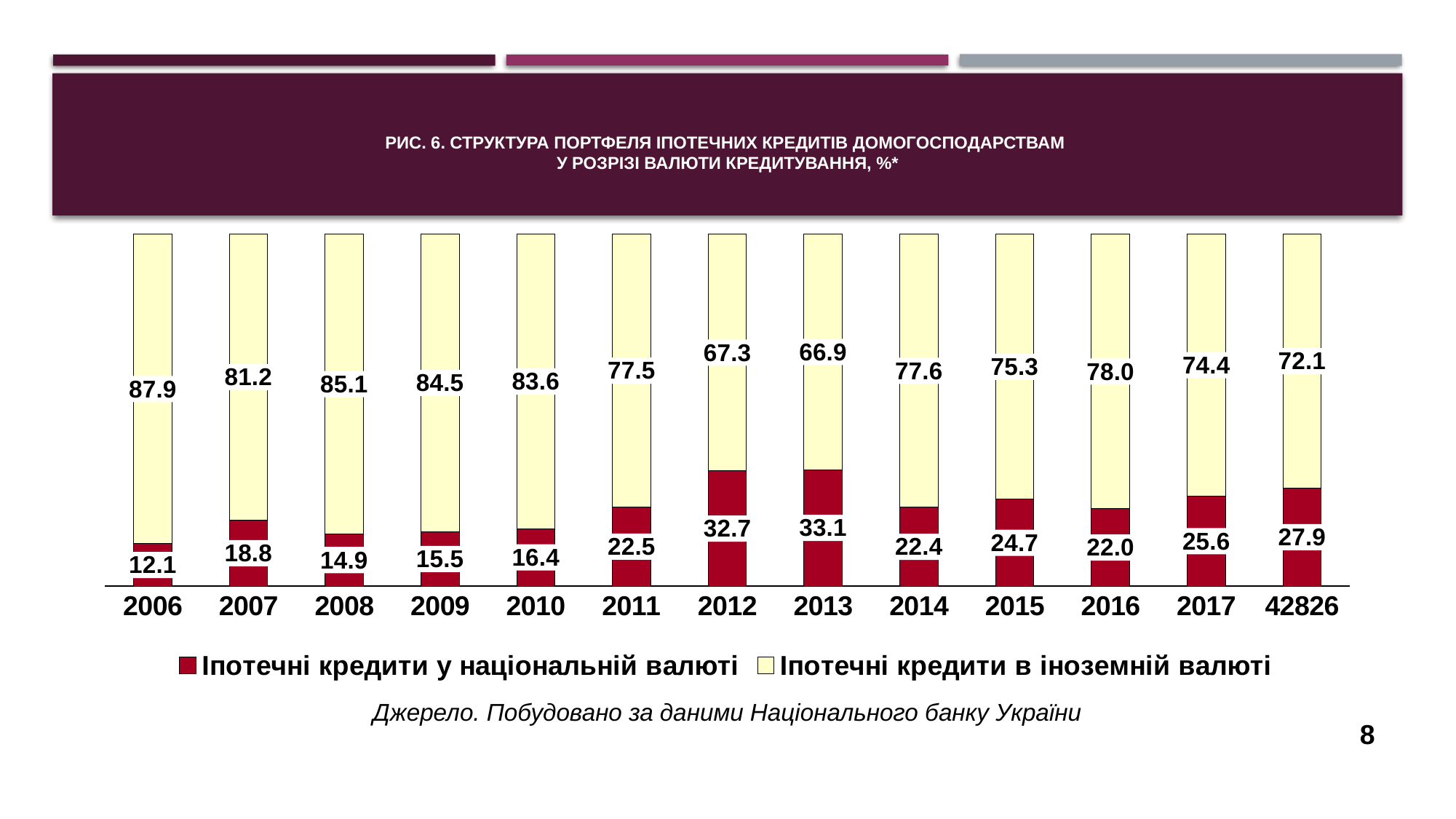
What kind of chart is shown on the slide? Stacked bar chart What is the value for mortgage loans in national currency (Іпотечні кредити у національній валюті) in 2006? 12.1 What is the difference between the foreign currency value and the national currency value in 2012? 34.6 In which year is the share of mortgage loans in foreign currency the lowest? 2013 What is the total of the stacked bar for 2006? 100 What is the value for mortgage loans in foreign currency (Іпотечні кредити в іноземній валюті) in 2013? 66.9 In which year is the share of mortgage loans in national currency the highest? 2013 What is the value for mortgage loans in national currency in 2017? 25.6 Which year has a larger value for mortgage loans in national currency, 2015 or 2016? 2015 How many series does the legend list? 2 How many years (categories) are shown on the x axis? 13 In which year is the share of mortgage loans in foreign currency the highest? 2006